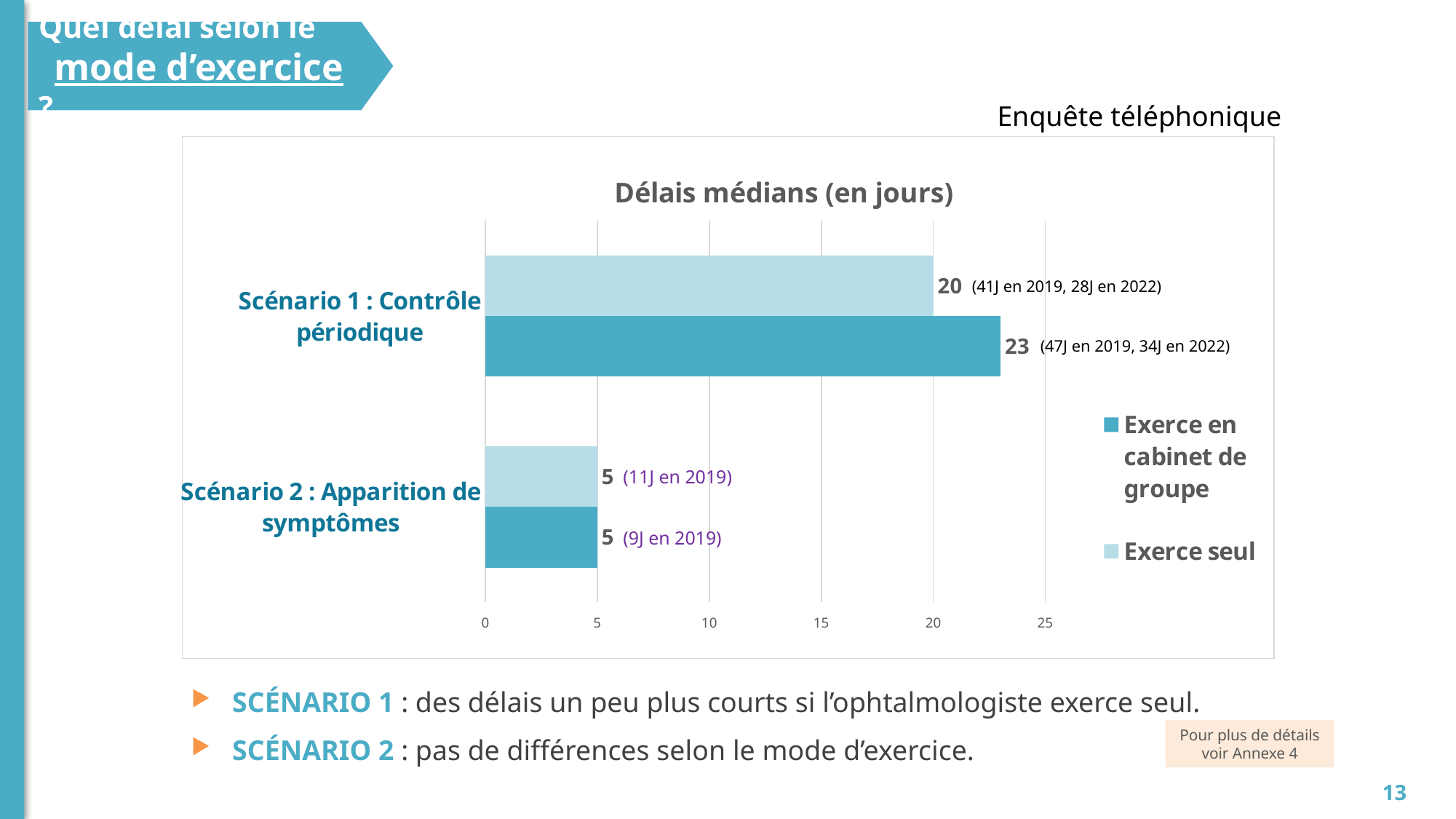
In Scénario 1 : Contrôle périodique, which series has the larger value, 'Exerce en cabinet de groupe' or 'Exerce seul'? Exerce en cabinet de groupe How many categories (scenarios) are shown on the chart? 2 How many series does the legend list? 2 What is the median delay for 'Exerce en cabinet de groupe' in Scénario 1 : Contrôle périodique? 23 Is the value for 'Exerce en cabinet de groupe' in Scénario 1 : Contrôle périodique greater or less than 25? less What is the median delay for 'Exerce seul' in Scénario 2 : Apparition de symptômes? 5 What is the title of the chart? Délais médians (en jours) Which legend entry is shown in the lighter blue colour? Exerce seul What is the median delay for 'Exerce seul' in Scénario 1 : Contrôle périodique? 20 Which bar on the chart has the highest value? Exerce en cabinet de groupe, Scénario 1 : Contrôle périodique What type of chart is shown on the slide? bar chart What is the difference between the 'Exerce en cabinet de groupe' and 'Exerce seul' values in Scénario 1 : Contrôle périodique? 3